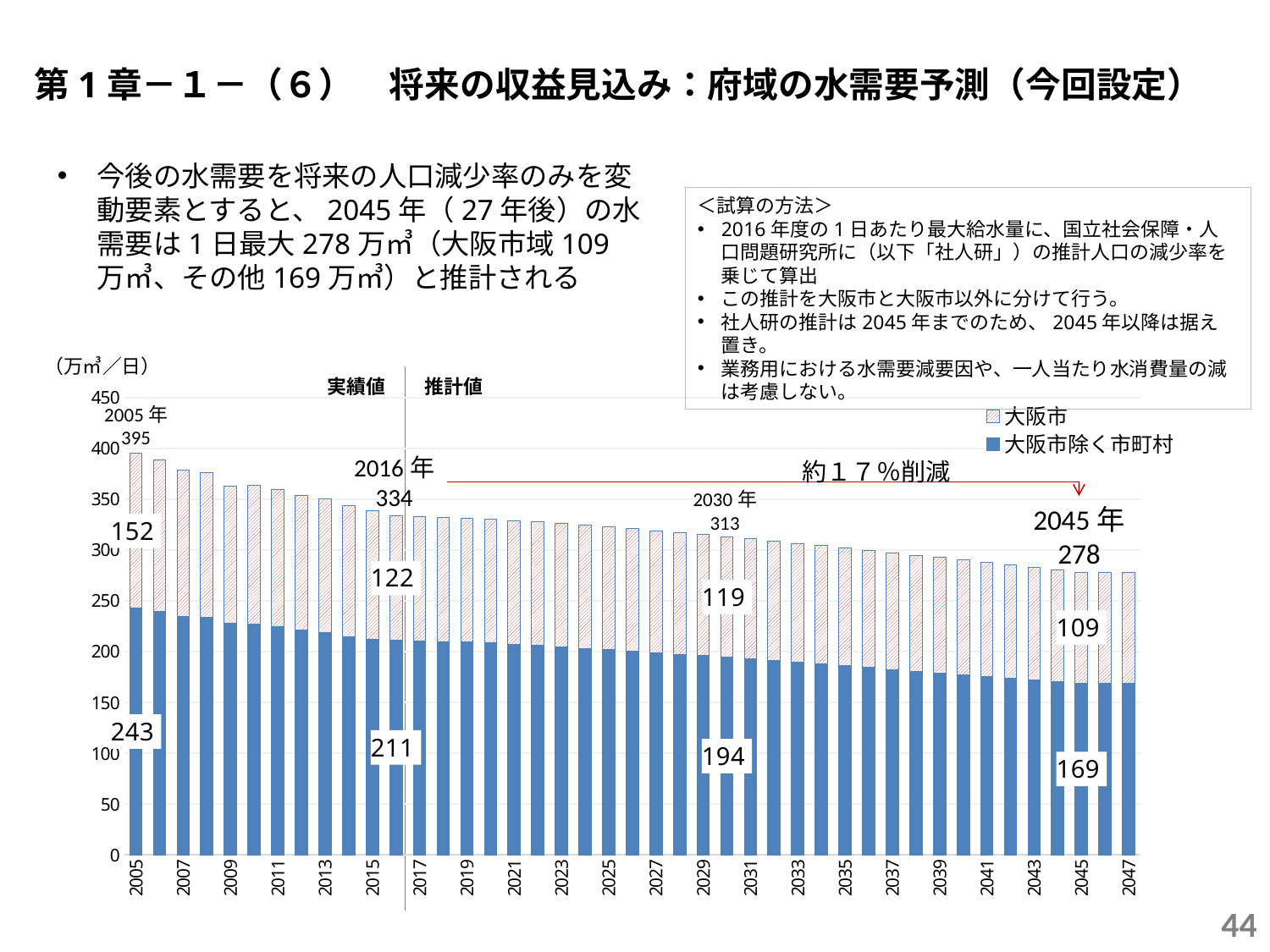
What is the total water demand shown for 2005? 395 Which year has the highest total water demand? 2005 What is the value for 大阪市 in 2030? 119 Which is larger, the 大阪市 value in 2005 or in 2045? 2005 What is the total of the stacked bar for 2045? 278 What is the value for 大阪市除く市町村 in 2045? 169 Is the total value for 2047 greater or less than 300? less How many series does the legend list? 2 What is the difference between the 大阪市除く市町村 value in 2005 and in 2045? 74 Do the total values rise or fall from 2005 to 2047? fall What is the difference between the total for 2005 and the total for 2045? 117 What is the value for 大阪市除く市町村 in 2016? 211